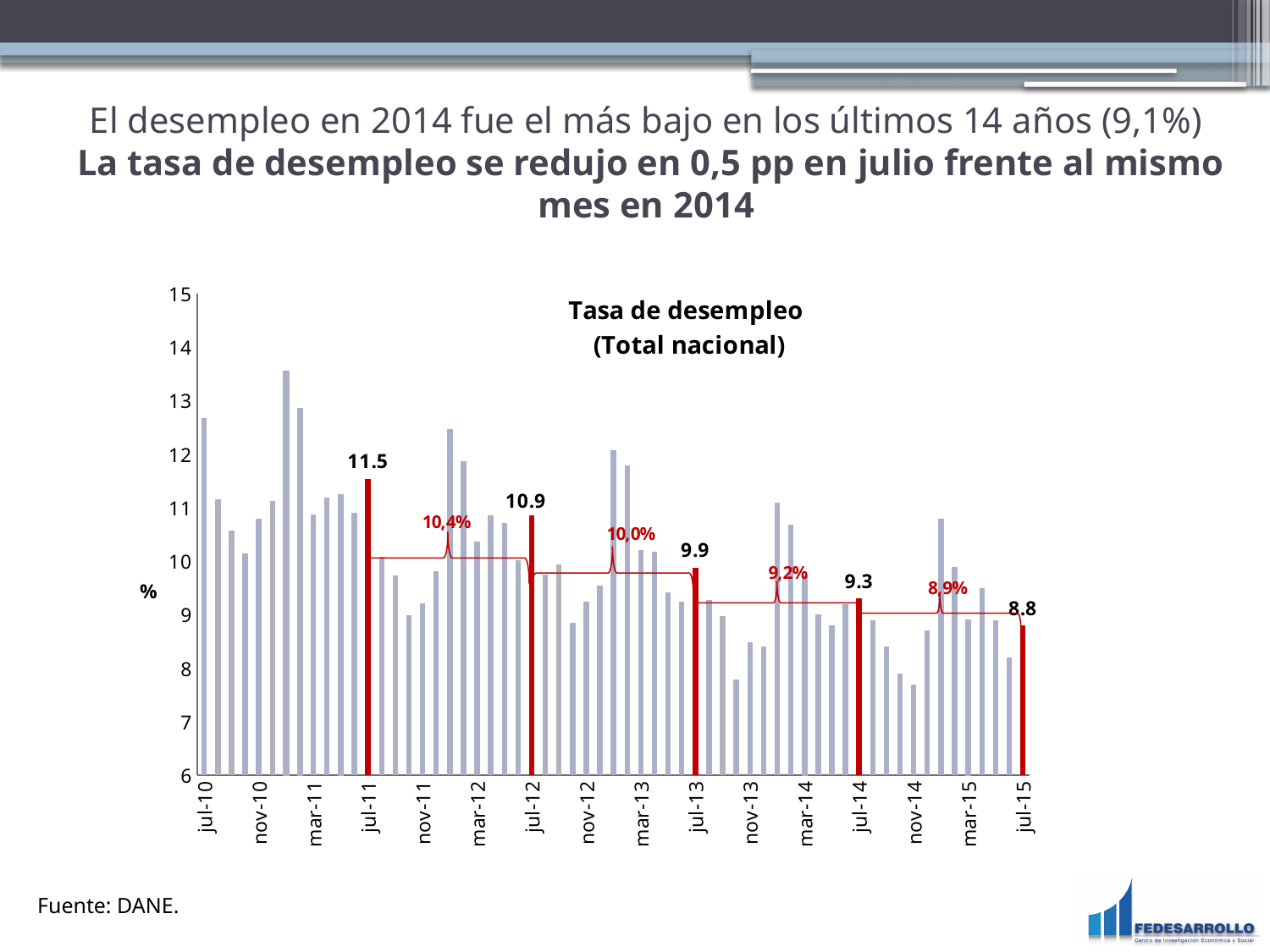
What is the unemployment rate labelled for jul-13? 9.9 Do the highlighted July values rise or fall from jul-11 to jul-15? fall What is the unemployment rate labelled for jul-12? 10.9 Which of the highlighted July bars has the highest value? jul-11 What is the unemployment rate labelled for jul-11? 11.5 Is the value for jul-10 greater or less than 12? greater What is the difference between the labelled values for jul-14 and jul-15? 0.5 What type of chart is shown on the slide? bar chart What is the unemployment rate labelled for jul-15? 8.8 What is the unemployment rate labelled for jul-14? 9.3 What is the title of the chart? Tasa de desempleo (Total nacional) What is the difference between the labelled values for jul-11 and jul-15? 2.7